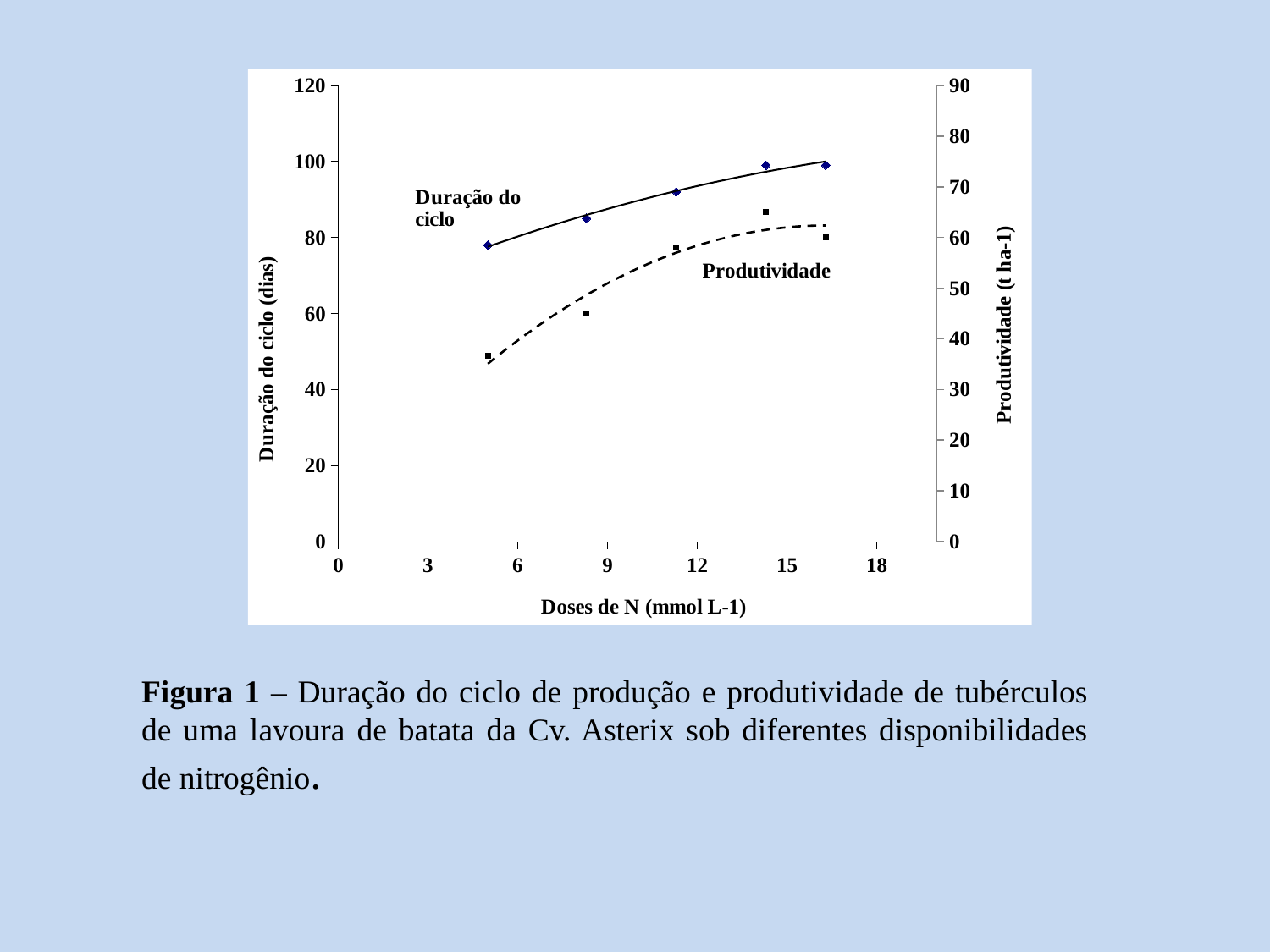
How many data points are plotted for the Duração do ciclo series? 5 Which is larger: the Duração do ciclo at the lowest N dose or at the highest N dose? at the highest N dose How many data points are plotted for the Produtividade series? 5 Is the Produtividade value at the lowest N dose greater or less than 50? less Is the Duração do ciclo value at the lowest N dose greater or less than 60? greater What is the title of the right-hand y axis? Produtividade (t ha-1) How many series are plotted on the chart? 2 Is the Produtividade value at the lowest N dose greater or less than 30? greater What kind of chart is shown on the slide? line chart What is the title of the x axis? Doses de N (mmol L-1) Does Duração do ciclo rise or fall as Doses de N increases? rise